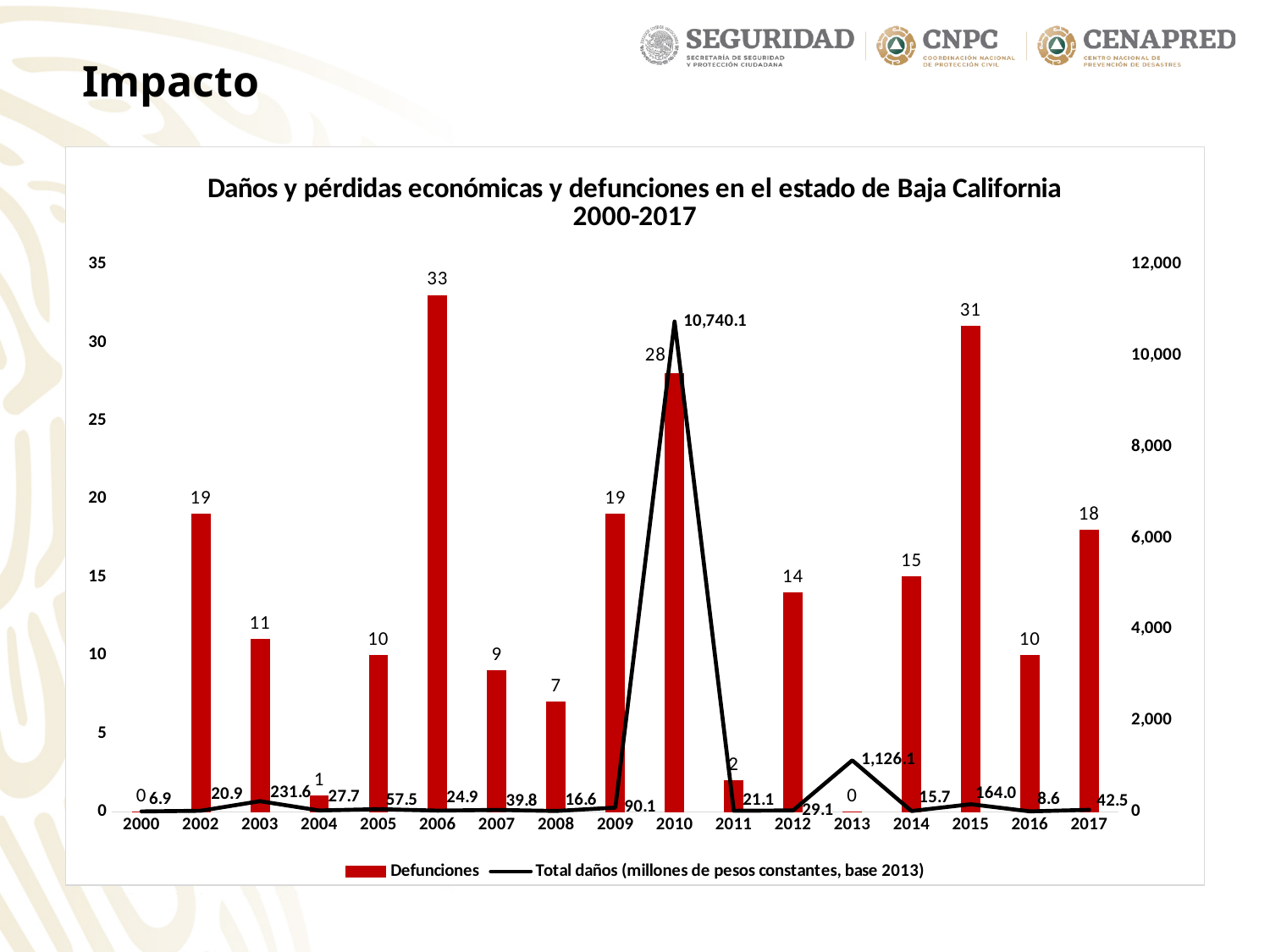
Which year has the lowest Total daños value? 2000 Which year has more Defunciones, 2009 or 2012? 2009 How many deaths (Defunciones) are shown for 2006? 33 How many years are shown on the x axis? 17 What kind of chart is this? Combined bar and line chart How many deaths (Defunciones) are shown for 2015? 31 How many series does the legend list? 2 Which year has the highest Total daños value? 2010 What is the Total daños value for 2013? 1,126.1 What is the difference in Defunciones between 2006 and 2015? 2 What is the Total daños value for 2010? 10,740.1 Which year has the highest number of Defunciones? 2006